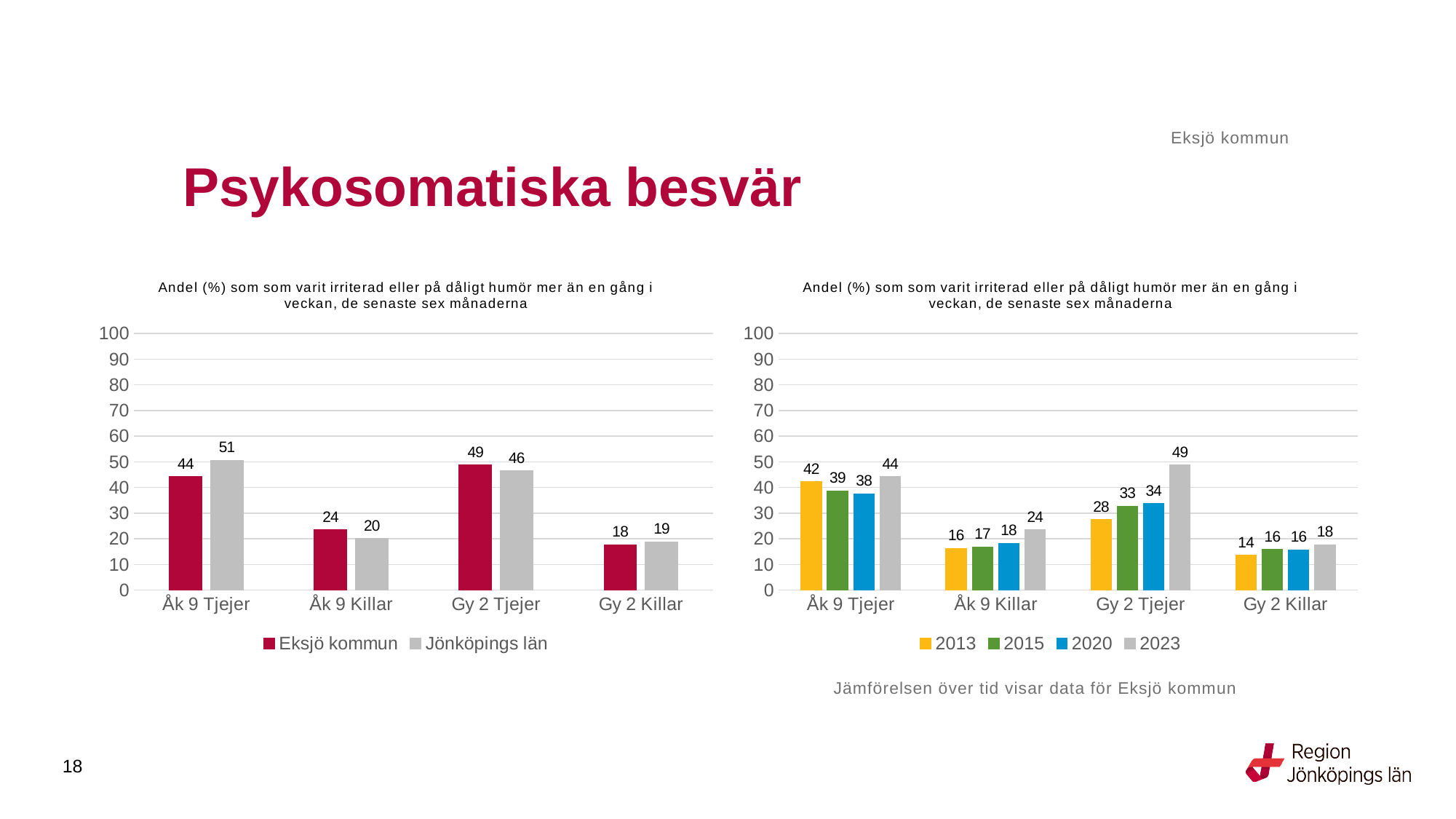
In the left chart, how many series does the legend list? 2 In the left chart, which category has the highest value for Eksjö kommun? Gy 2 Tjejer In the right chart, what is the value for 2023 for Gy 2 Tjejer? 49 In the left chart, what is the value for Jönköpings län for Gy 2 Killar? 19 In the right chart, what is the value for 2013 for Gy 2 Killar? 14 In the left chart, what is the value for Eksjö kommun for Åk 9 Tjejer? 44 In the left chart, what is the difference between Jönköpings län and Eksjö kommun for Åk 9 Tjejer? 7 In the right chart, which category has the lowest value for 2020? Gy 2 Killar What type of chart is the right chart? Bar chart In the right chart, what is the difference between the 2023 and 2013 values for Gy 2 Tjejer? 21 In the right chart, how many series does the legend list? 4 In the left chart, which is larger for Åk 9 Killar: Eksjö kommun or Jönköpings län? Eksjö kommun